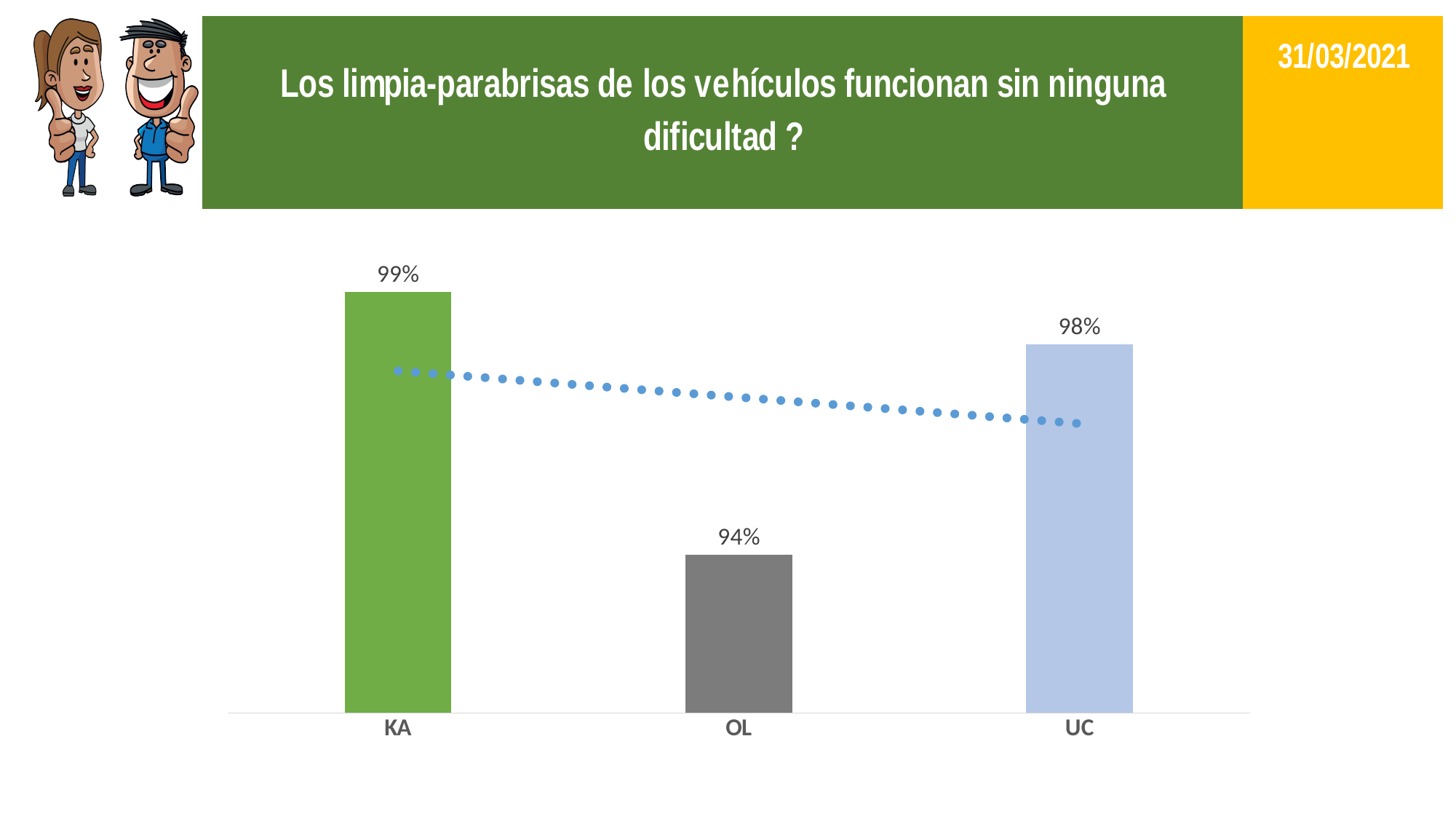
Which is larger, the value for OL or the value for UC? UC What kind of chart is shown on the slide? bar chart What is the difference between the values for UC and OL? 4% What is the value for UC? 98% What is the value for KA? 99% What is the difference between the values for KA and OL? 5% Which category has the highest value? KA How many categories are shown on the x axis? 3 What date is shown in the top right corner of the slide? 31/03/2021 What colour is the bar for OL? grey Which category has the lowest value? OL What is the value for OL? 94%